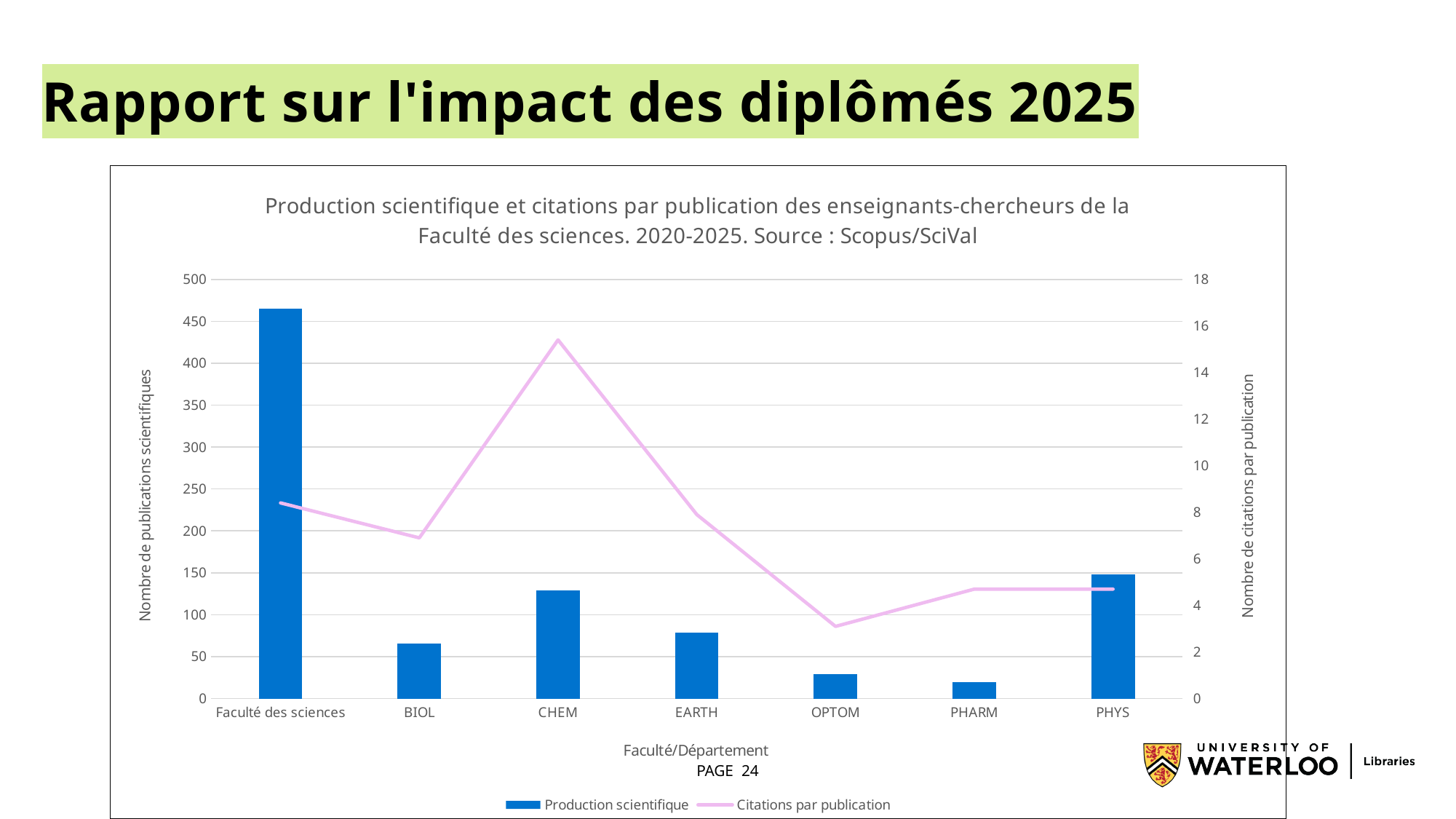
Which category has the lowest bar for Production scientifique? PHARM Is the Production scientifique value for CHEM greater or less than 100? greater What are the two series named in the chart's legend? Production scientifique and Citations par publication Which category has the highest bar for Production scientifique? Faculté des sciences Which category has the highest value on the Citations par publication line? CHEM Which has the larger Production scientifique bar, CHEM or EARTH? CHEM How many categories are shown on the x axis of the chart? 7 What kind of chart is shown on the slide? A combined bar and line chart Is the Citations par publication value for CHEM greater or less than 14? greater Which category has the lowest value on the Citations par publication line? OPTOM Is the Production scientifique value for BIOL greater or less than 100? less How many series does the chart's legend list? 2